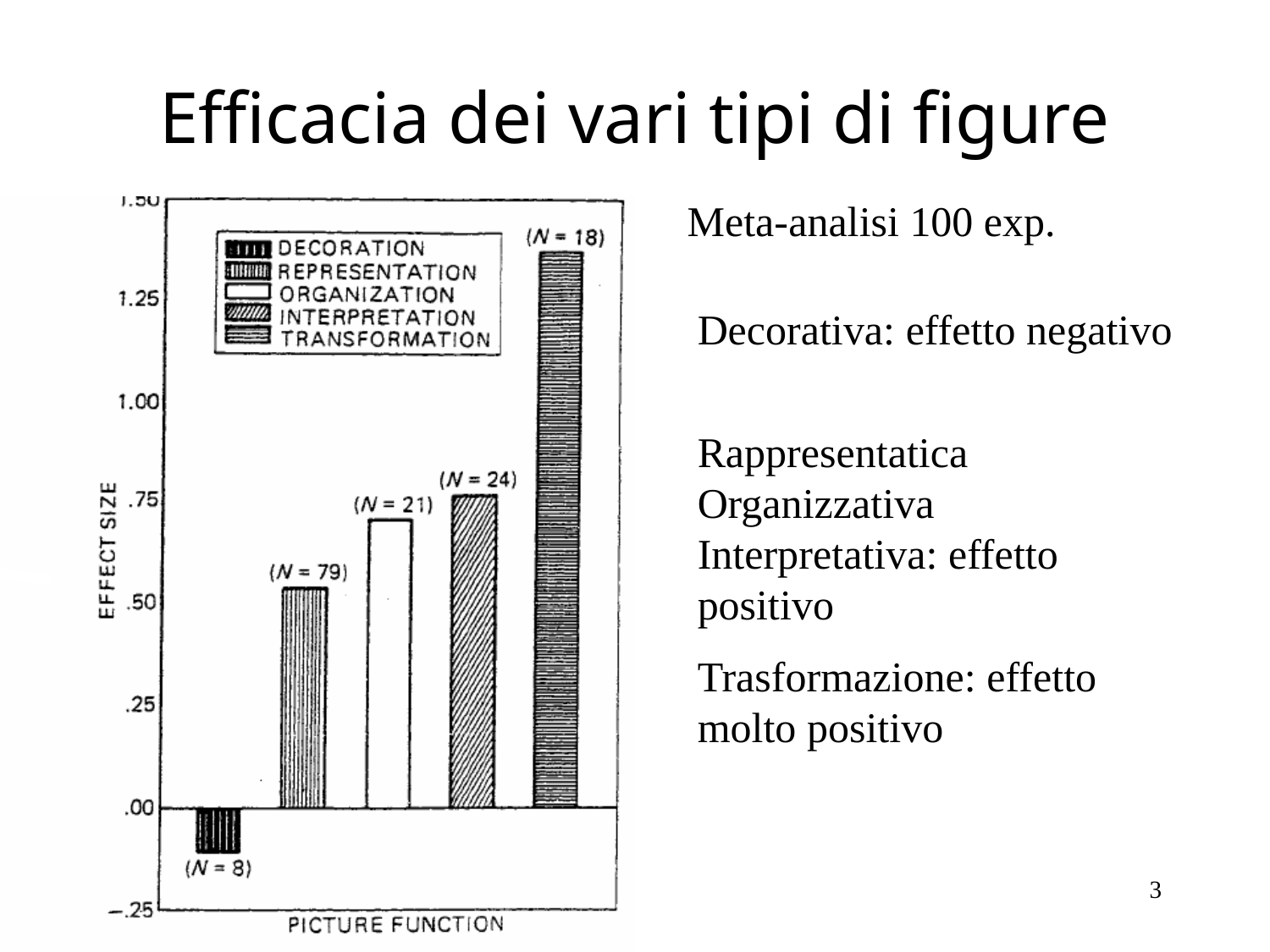
Which has a larger effect size, Representation or Organization? Organization Which picture function has the highest effect size? Transformation What is the N value shown above the Representation bar? N = 79 How many bars (picture functions) are plotted in the chart? 5 Is the effect size for Decoration greater or less than .00? less Is the effect size for Transformation greater or less than 1.25? greater Which picture function has the lowest effect size? Decoration What is the N value shown for the Decoration bar? N = 8 What kind of chart is shown on the slide? bar chart What is the label of the y axis? EFFECT SIZE How many entries does the chart's legend list? 5 What is the N value shown for the Transformation bar? N = 18